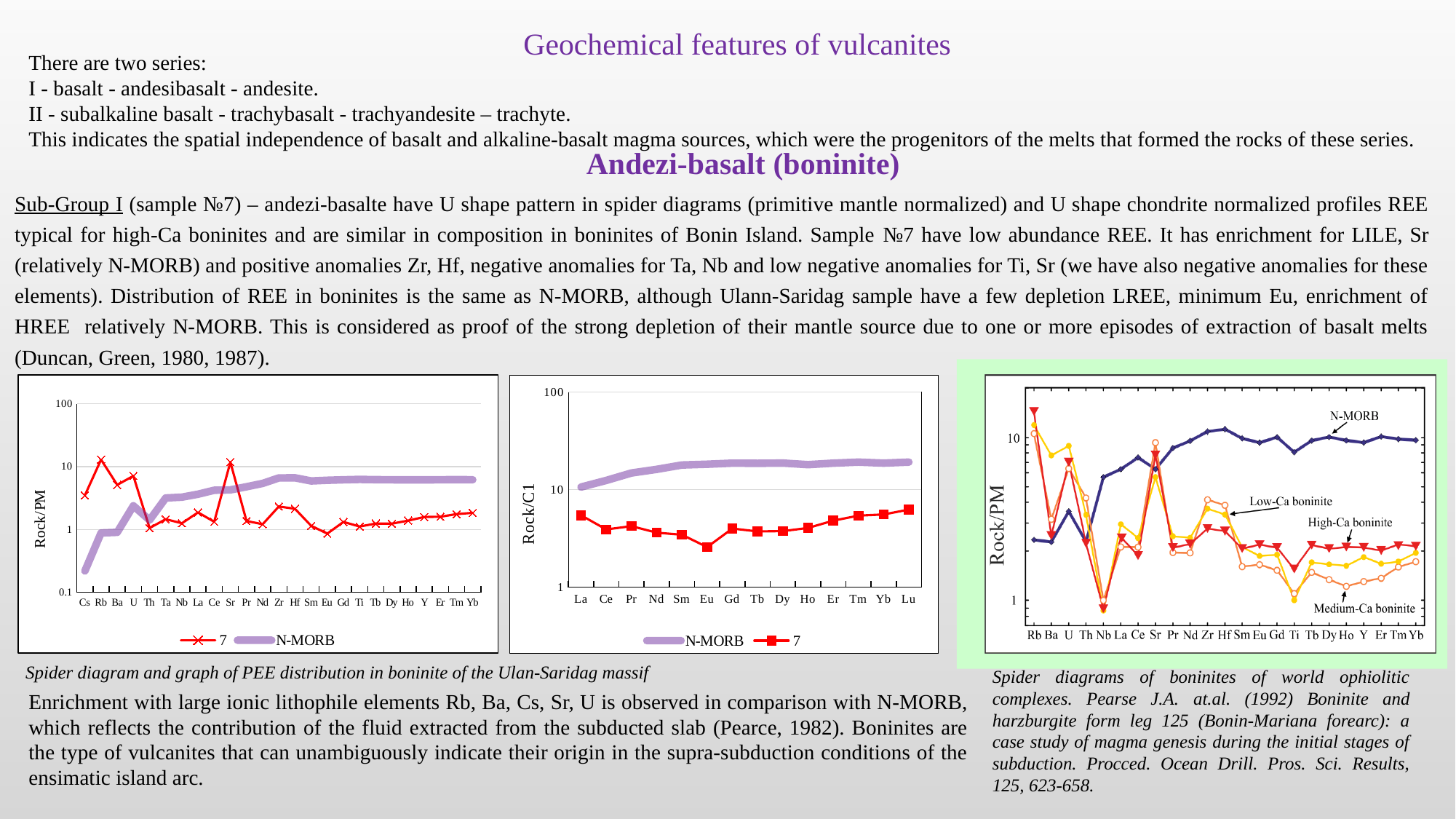
In the middle chart (Rock/C1), how many elements are shown along the x axis? 14 In the left chart (Rock/PM), is the value of series 7 at Rb greater or less than 10? greater In the left chart (Rock/PM), is the value of N-MORB at Cs greater or less than 1? less In the left chart (Rock/PM), which series has the larger value at Yb, 7 or N-MORB? N-MORB In the right chart (spider diagrams of boninites of world ophiolitic complexes), how many series are labelled? 4 In the middle chart (Rock/C1), is the value of N-MORB at Lu greater or less than 10? greater In the middle chart (Rock/C1), does the N-MORB line rise or fall from La to Lu? rise In the left chart (Rock/PM), which series has the larger value at Rb, 7 or N-MORB? 7 In the left chart (Rock/PM), how many elements are shown along the x axis? 25 In the middle chart (Rock/C1), at which element does series 7 reach its lowest value? Eu In the left chart (Rock/PM), how many series does the legend list? 2